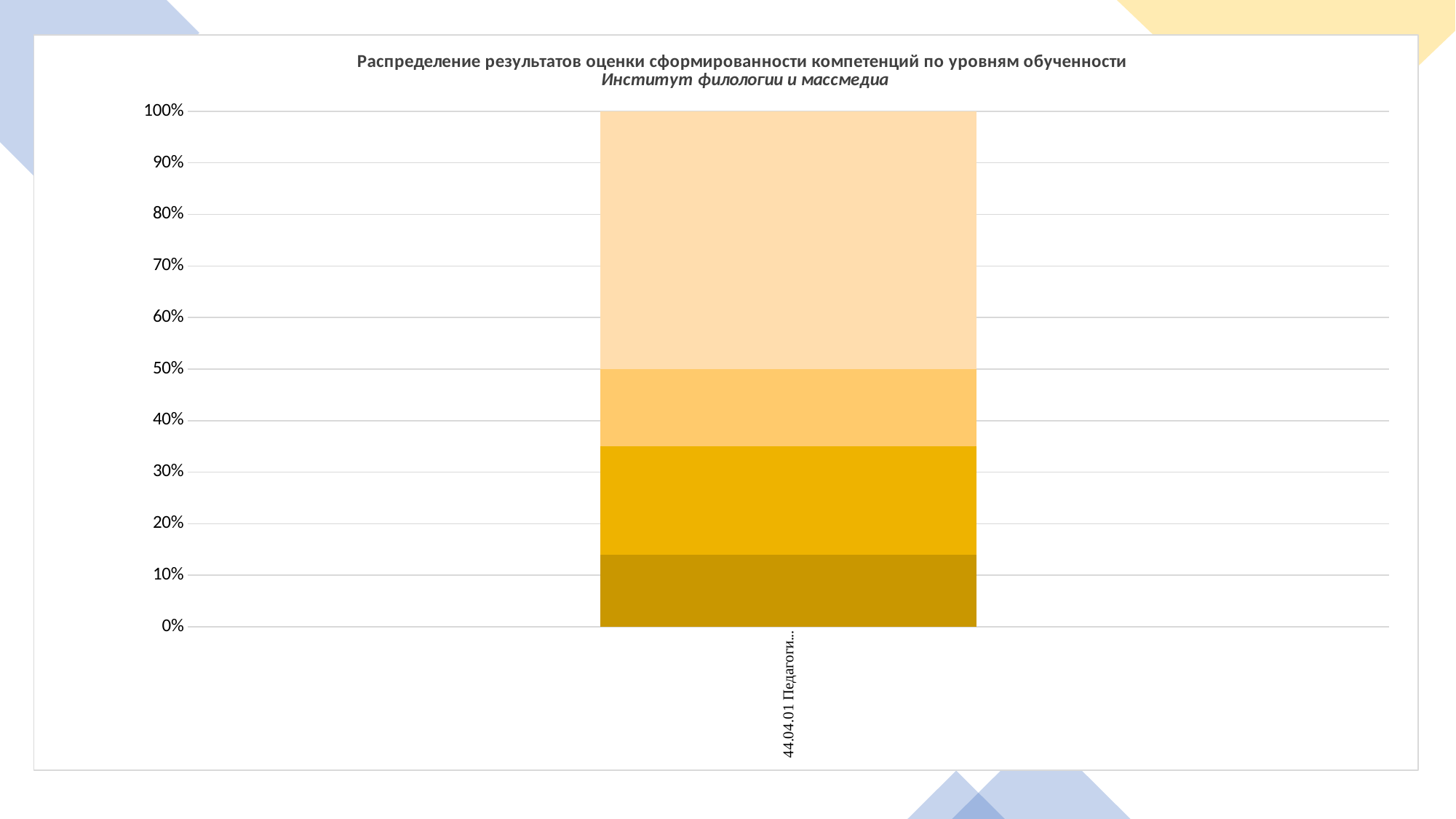
How many categories are plotted on the x axis of the chart? 1 Is the top of the darkest bottom segment greater or less than 20%? less Is the top of the second segment from the bottom greater or less than 40%? less Which segment of the stacked bar is the largest: the lightest top segment or the darkest bottom segment? The lightest top segment What kind of chart is shown on the slide? Stacked bar chart Is the top of the darkest bottom segment greater or less than 10%? greater What value does the top of the stacked bar reach on the y axis? 100% What is the italic subtitle of the chart? Институт филологии и массмедиа How many coloured segments make up the single stacked bar? 4 Is the lightest top segment of the bar larger or smaller than the second segment from the bottom? larger What is the first line of the chart title? Распределение результатов оценки сформированности компетенций по уровням обученности